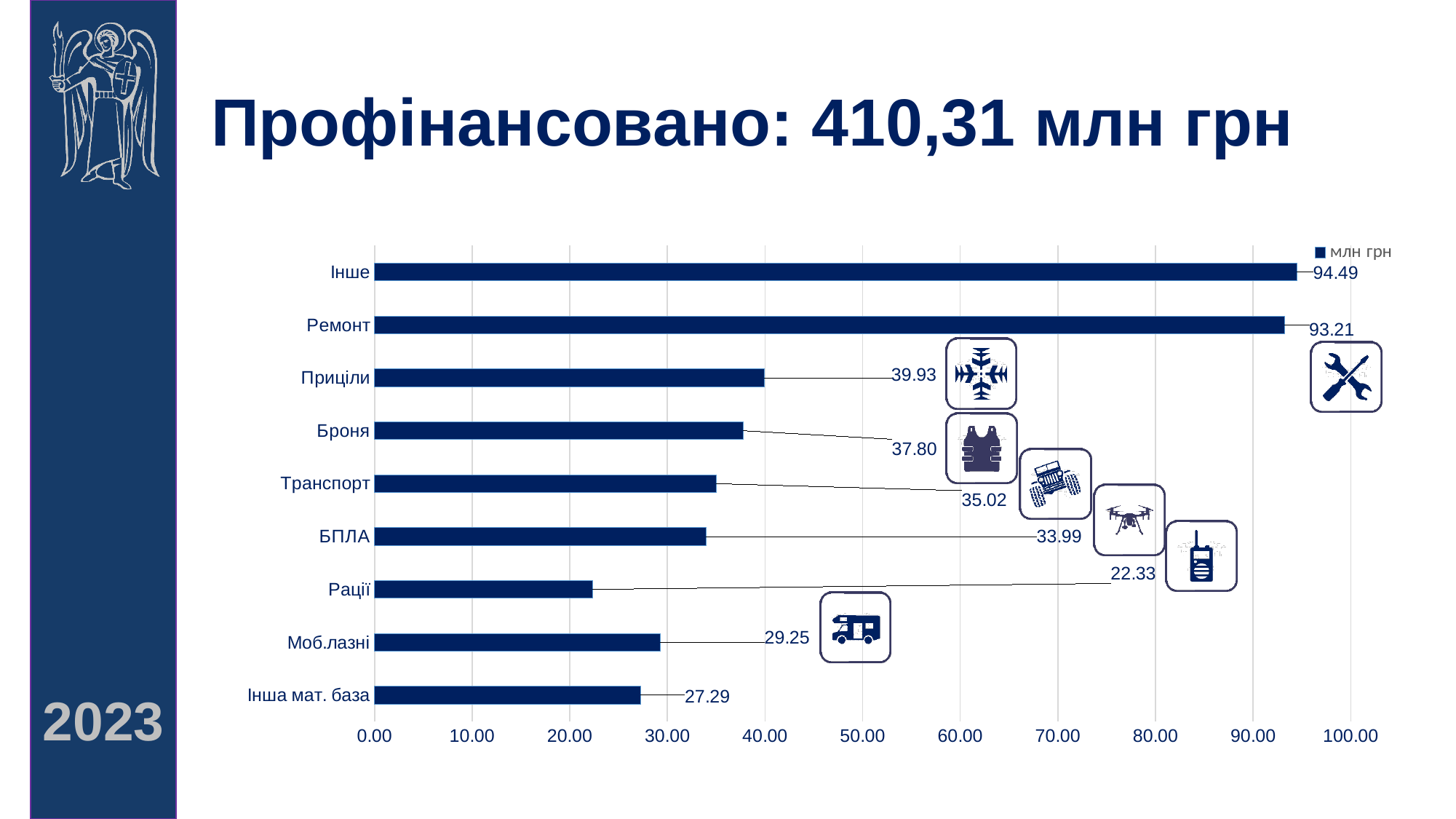
What kind of chart is shown on the slide? bar chart What is the difference between the values for Приціли and Броня? 2.13 What is the legend entry of the chart? млн грн What is the value for Інша мат. база? 27.29 Which is larger, the value for Транспорт or the value for Моб.лазні? Транспорт How many categories are shown in the chart? 9 Is the value for Інше greater or less than 90.00? greater What is the value for БПЛА? 33.99 Which category has the lowest value? Рації What is the value for Рації? 22.33 What is the value for Ремонт? 93.21 Which category has the highest value? Інше